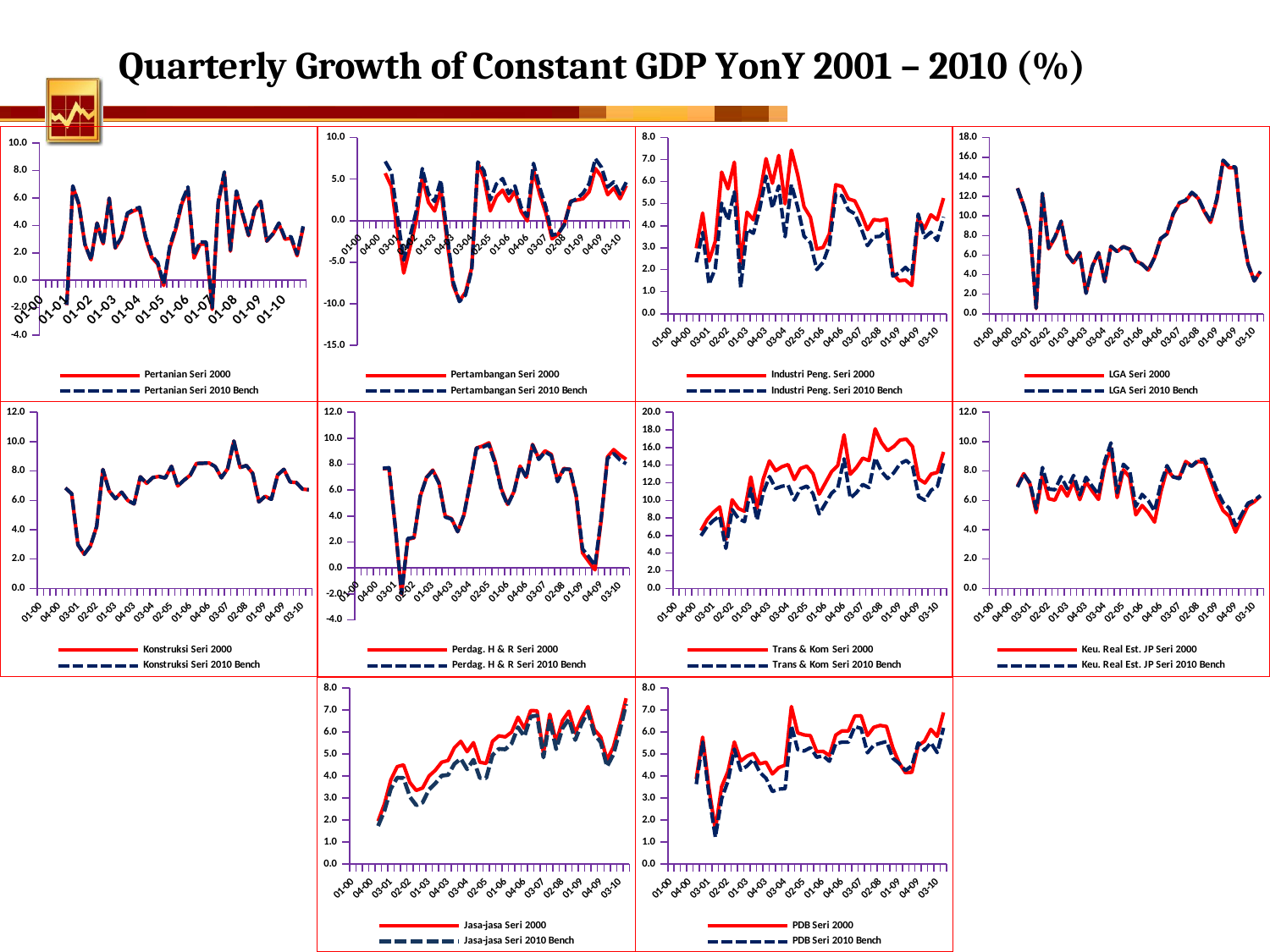
What are the two legend entries of the Konstruksi chart? Konstruksi Seri 2000 and Konstruksi Seri 2010 Bench What kind of chart is the Pertanian chart (top-left)? Line chart In the Konstruksi chart, is the lowest value of Konstruksi Seri 2000 greater or less than 4.0? less How many charts are shown on the slide? 10 How many series does the legend of the PDB chart list? 2 In the Pertambangan chart, is the lowest value of Pertambangan Seri 2000 greater or less than -5.0? less In the LGA chart, is the highest value of LGA Seri 2000 greater or less than 14.0? greater How many series does the legend of the Pertanian chart list? 2 In the Jasa-jasa chart, do the values of Jasa-jasa Seri 2000 generally rise or fall from 01-00 to 03-10? rise In the Trans & Kom chart, which series is higher at the last point (03-10): Trans & Kom Seri 2000 or Trans & Kom Seri 2010 Bench? Trans & Kom Seri 2000